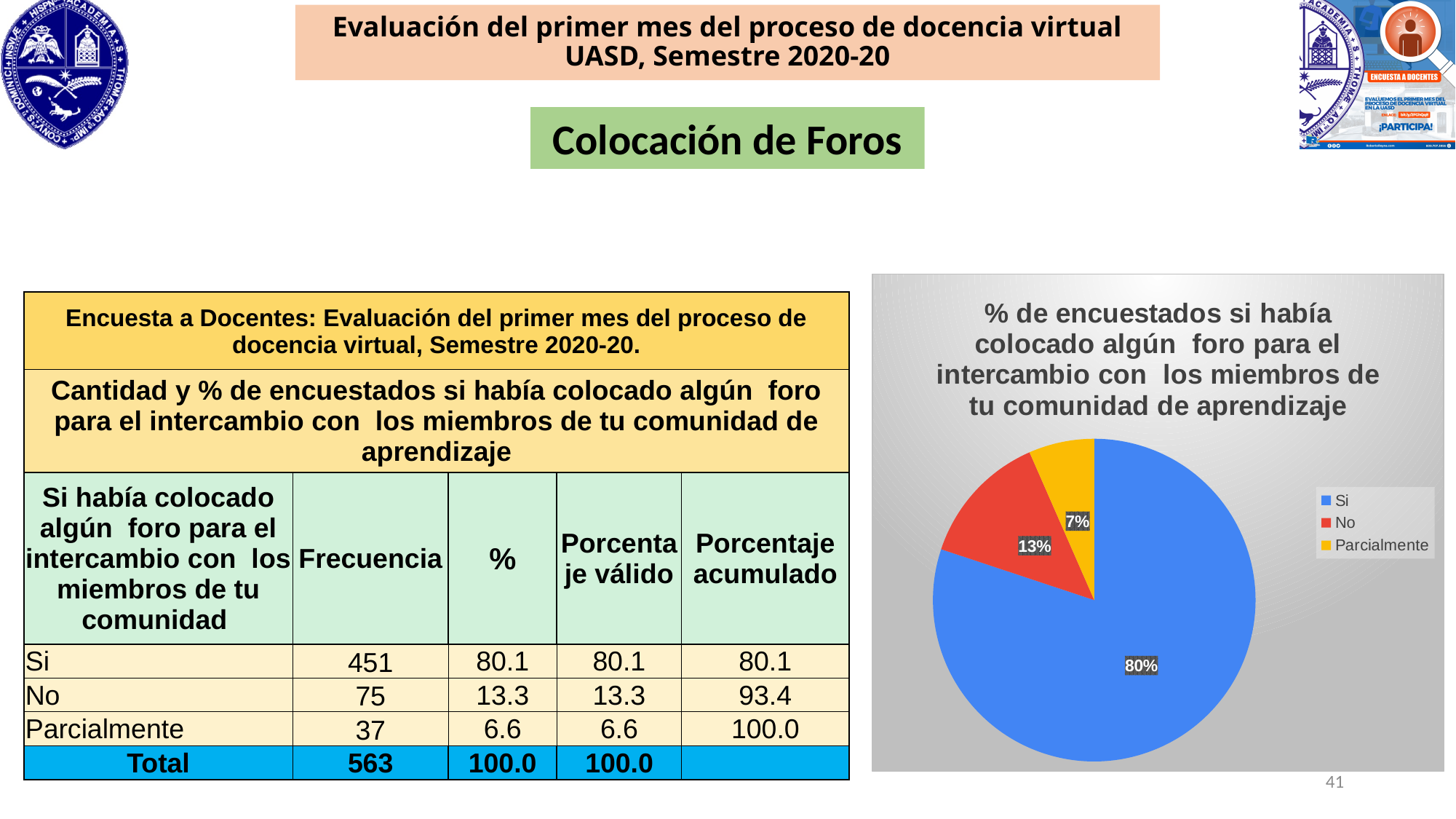
How many categories does the pie chart show? 3 What percentage does the pie chart show for "No"? 13% What percentage does the pie chart show for "Si"? 80% Which category has the smallest slice in the pie chart? Parcialmente How many entries does the pie chart legend list? 3 What percentage does the pie chart show for "Parcialmente"? 7% What kind of chart is shown on the slide? pie chart What colour is the "Parcialmente" slice in the pie chart? yellow Which slice is larger in the pie chart, "No" or "Parcialmente"? No What is the difference in percentage points between the "Si" slice and the "No" slice in the pie chart? 67 Which category has the largest slice in the pie chart? Si What colour is the "Si" slice in the pie chart? blue